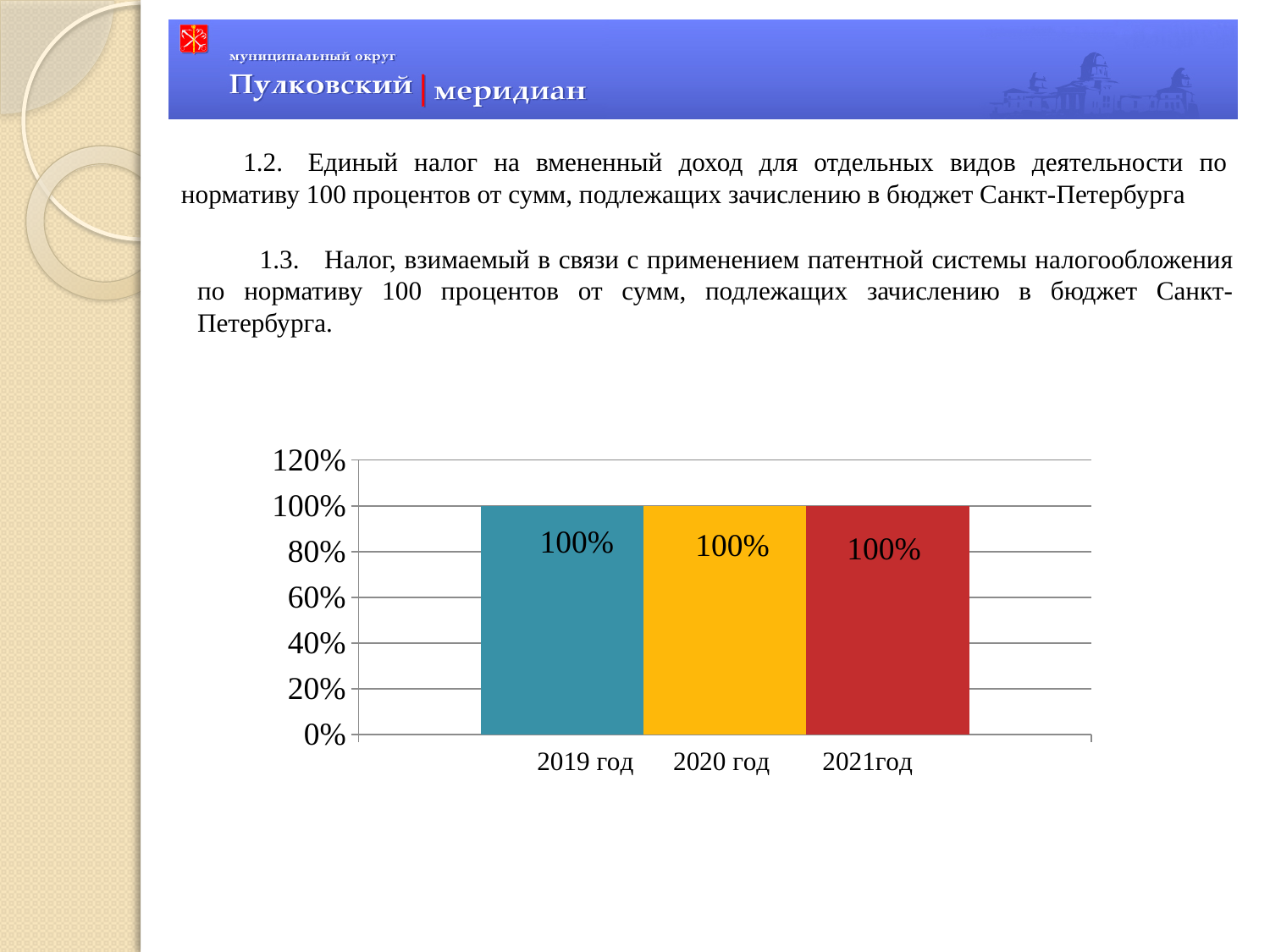
What is the difference between the values for 2019 год and 2021год? 0% Is the value for 2021год greater or less than 80%? greater What is the value for 2019 год? 100% How many bars are plotted in the chart? 3 Do the values rise, fall or stay the same from 2019 год to 2021год? stay the same Is the value for 2020 год larger than, smaller than or equal to the value for 2019 год? equal What is the value for 2020 год? 100% What colour is the bar for 2020 год? yellow What is the value for 2021год? 100% What kind of chart is shown on the slide? bar chart What is the highest tick shown on the vertical axis? 120%